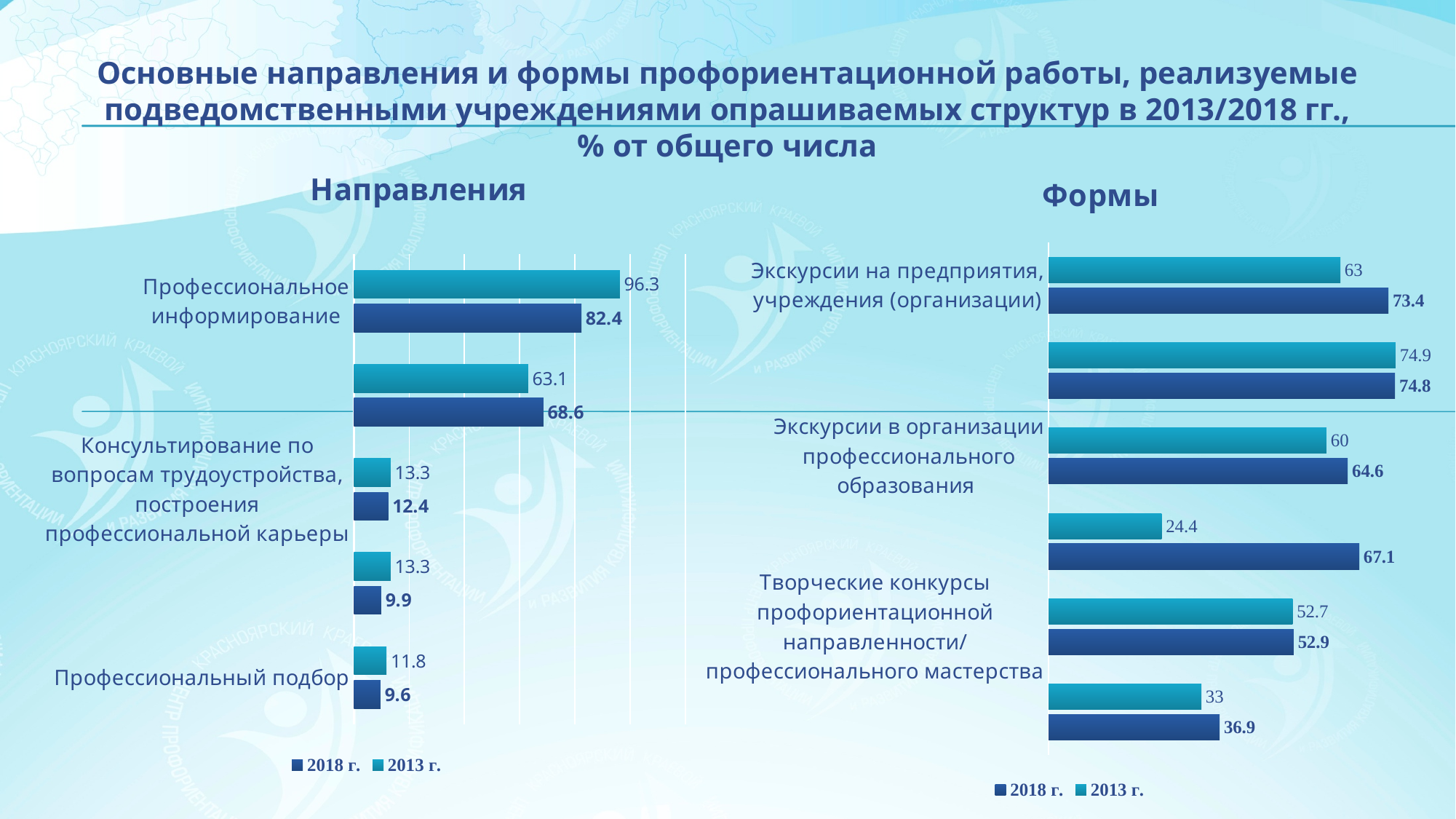
In the 'Формы' chart, what is the 2018 г. value for 'Экскурсии на предприятия, учреждения (организации)'? 73.4 In the 'Формы' chart, which year has the larger value for 'Экскурсии на предприятия, учреждения (организации)', 2013 г. or 2018 г.? 2018 г. In the 'Направления' chart, which category has the highest value? Профессиональное информирование In the 'Направления' chart, what is the 2018 г. value for 'Профессиональный подбор'? 9.6 In the 'Направления' chart, what is the 2013 г. value for 'Профессиональное информирование'? 96.3 In the 'Формы' chart, what is the 2013 г. value for 'Экскурсии в организации профессионального образования'? 60 How many series does the legend of the 'Направления' chart list? 2 What kind of chart is the 'Формы' chart? Bar chart In the 'Направления' chart, by how much does the 2013 г. value for 'Профессиональное информирование' exceed the 2018 г. value? 13.9 In the 'Направления' chart, what is the 2013 г. value for 'Консультирование по вопросам трудоустройства, построения профессиональной карьеры'? 13.3 In the 'Формы' chart, what is the difference between the 2018 г. and 2013 г. values for 'Экскурсии на предприятия, учреждения (организации)'? 10.4 In the 'Направления' chart, what is the 2018 г. value for 'Профессиональное информирование'? 82.4